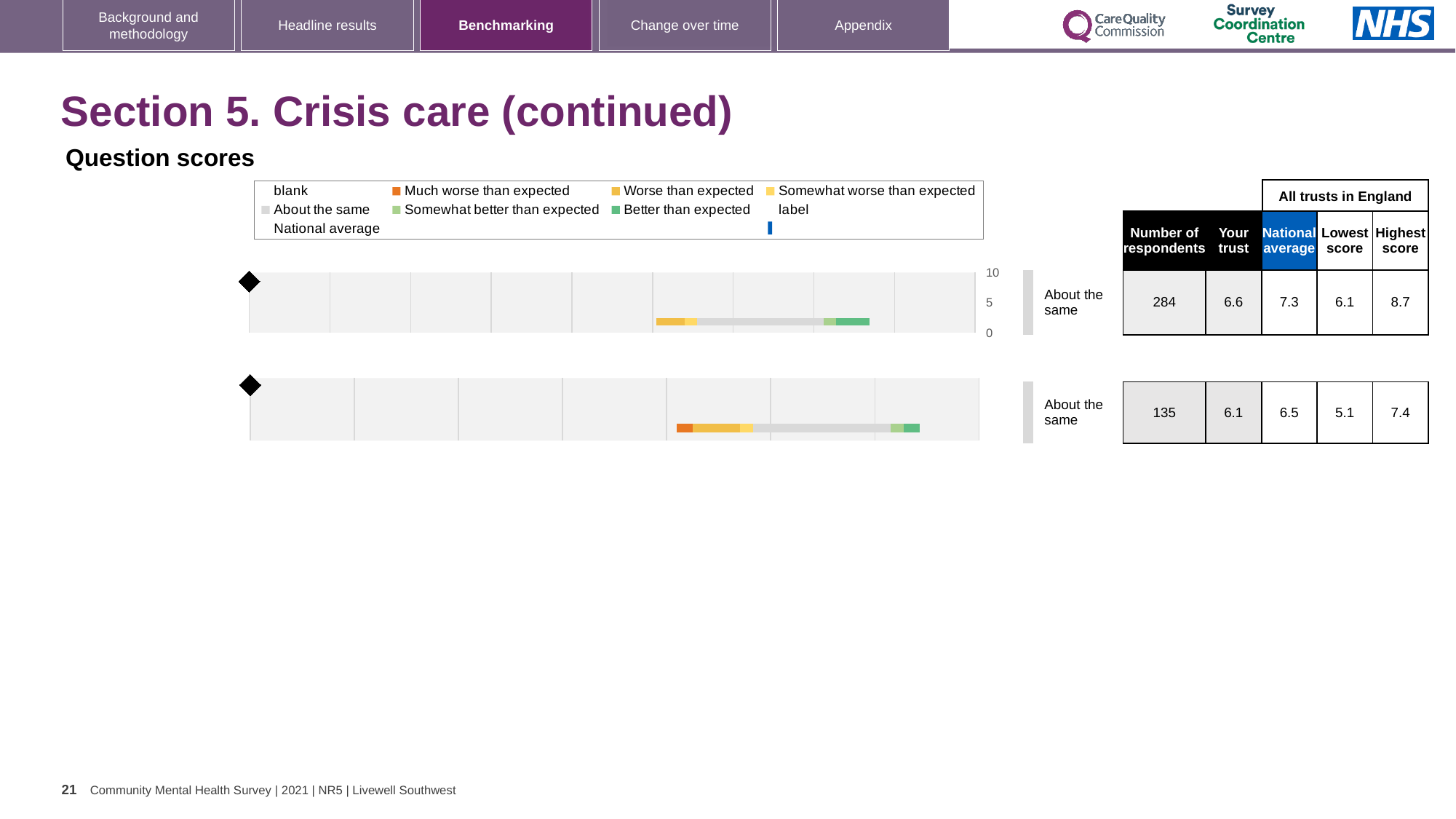
For the bottom chart, what is the 'Your trust' score shown in the table? 6.1 For the top chart, what is the difference between the national average and the 'Your trust' score? 0.7 For the bottom chart, what is the number of respondents shown in the table? 135 For the bottom chart, what is the difference between the highest score and the lowest score among all trusts in England? 2.3 What is the maximum value shown on the score axis of the top chart? 10 For the top chart, is the 'Your trust' score greater or less than the national average? less For the top chart, what is the national average shown in the table? 7.3 For the top chart, what is the 'Your trust' score shown in the table? 6.6 For the top chart, what is the highest score among all trusts in England? 8.7 Which chart has the higher 'Your trust' score, the top chart or the bottom chart? the top chart What benchmark category label is shown next to the bottom chart? About the same For the bottom chart, what is the lowest score among all trusts in England? 5.1